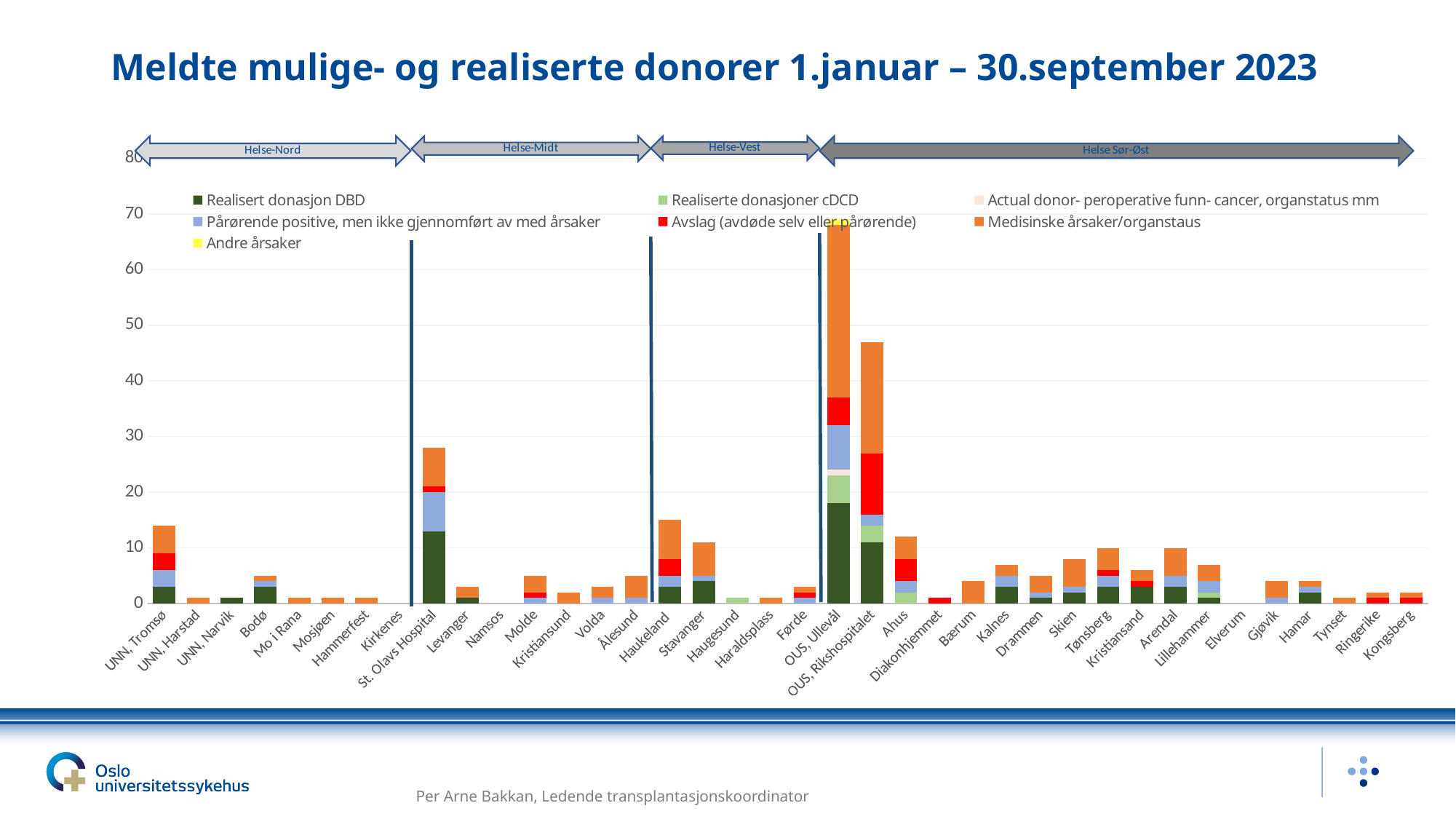
How many series does the legend list? 7 Is the total value for Bodø greater or less than 10? less Is the total value for OUS, Ullevål greater or less than 60? greater Which has the taller stacked bar, Haukeland or Stavanger? Haukeland Is the total value for OUS, Rikshospitalet greater or less than 40? greater Which legend entry is shown in dark green? Realisert donasjon DBD What kind of chart is shown on the slide? Stacked bar chart Which hospital has the tallest stacked bar? OUS, Ullevål What is the title of the chart? Meldte mulige- og realiserte donorer 1.januar – 30.september 2023 Which has the taller stacked bar, OUS, Rikshospitalet or St. Olavs Hospital? OUS, Rikshospitalet